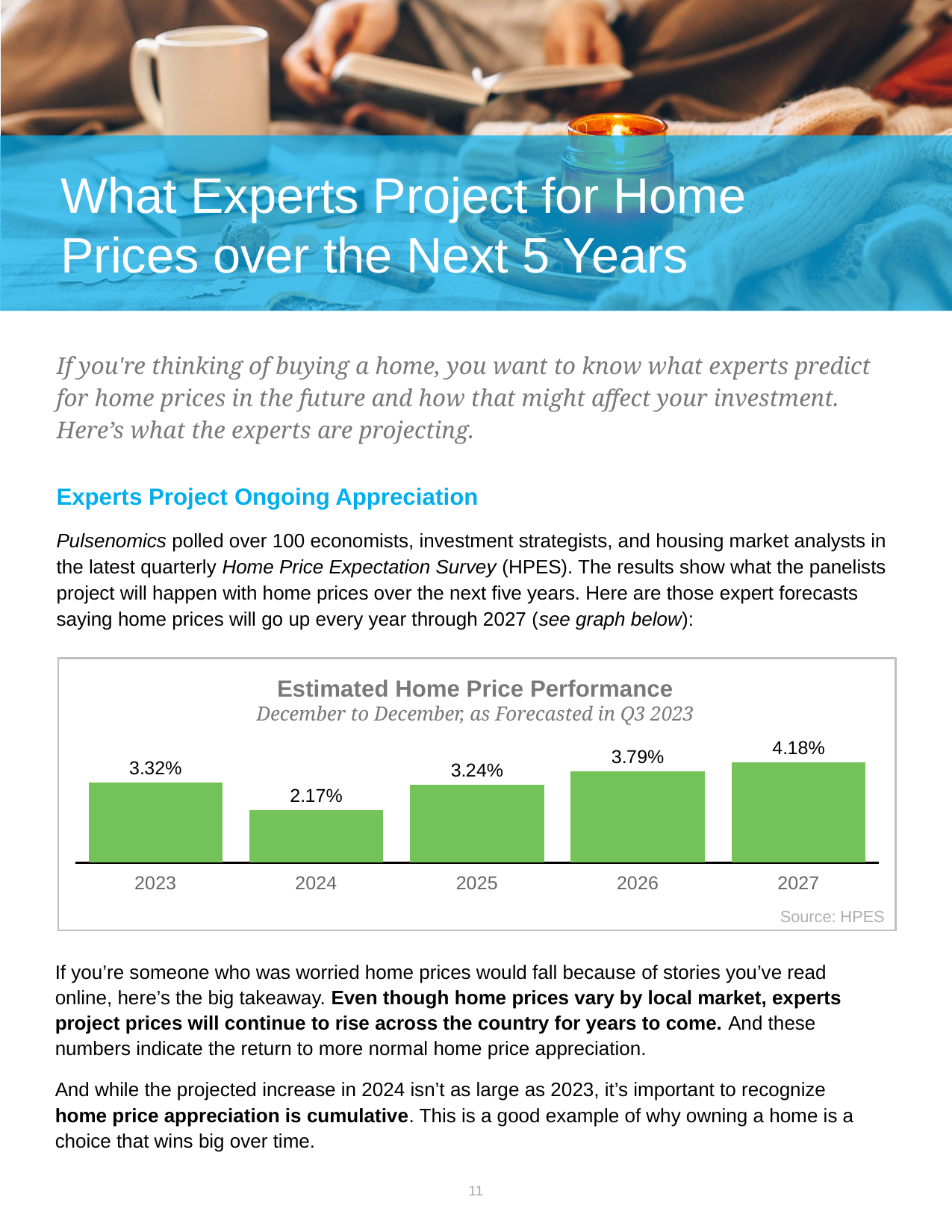
What kind of chart is used to show the estimated home price performance? Bar chart What is the estimated home price performance for 2027? 4.18% What is the difference between the estimated home price performance for 2027 and 2024? 2.01% How many years are shown in the chart? 5 Do the values rise or fall from 2024 to 2027? Rise Which year has a larger estimated home price performance, 2023 or 2025? 2023 What is the title of the chart? Estimated Home Price Performance What is the estimated home price performance for 2024? 2.17% What source is cited for the chart? HPES Which year has the lowest estimated home price performance? 2024 What is the estimated home price performance for 2023? 3.32% Which year has the highest estimated home price performance? 2027